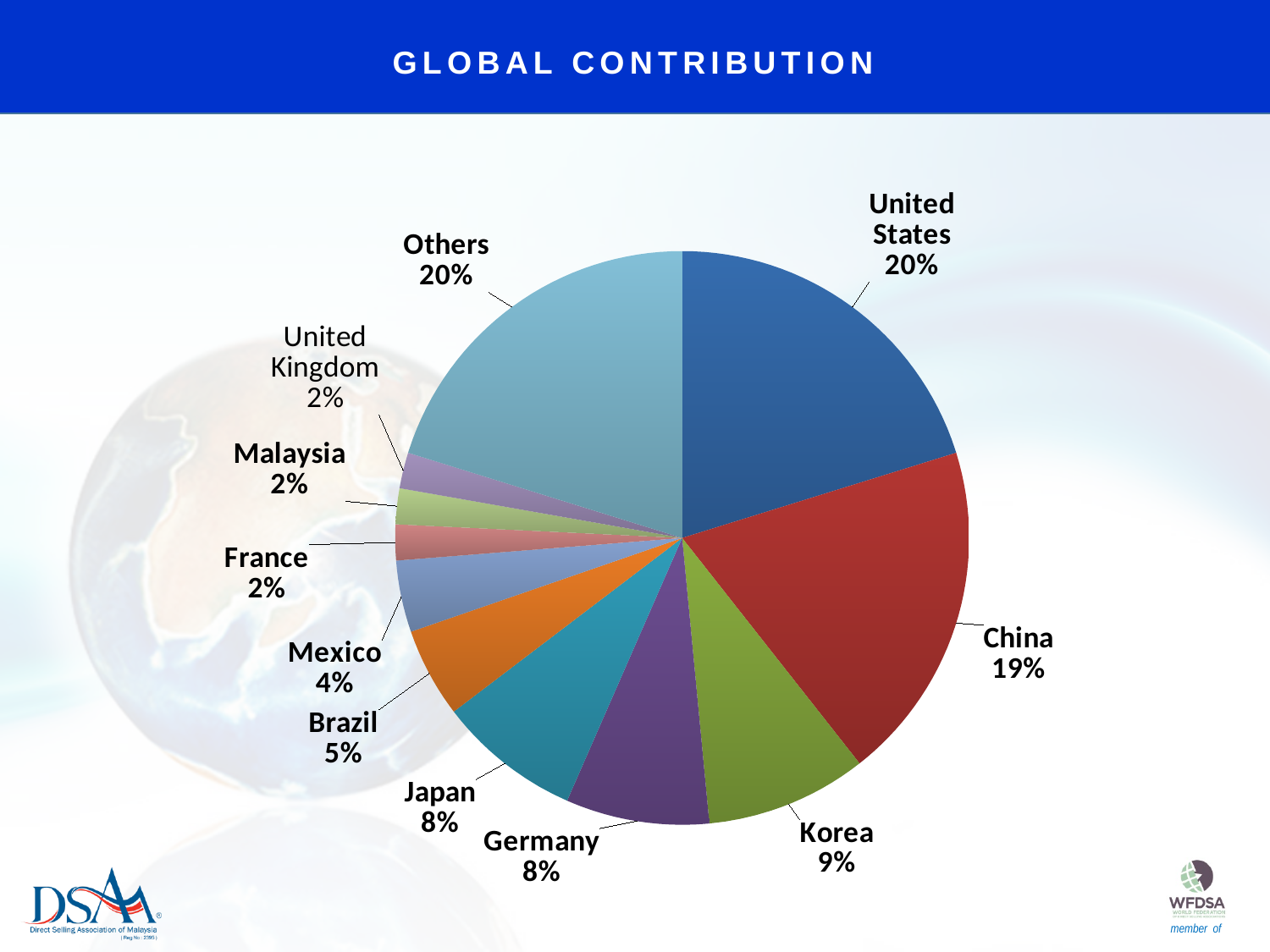
What is the difference between the shares for the United States and Brazil? 15% Which is larger, the share for the United States or the share for China? United States What type of chart is shown on the slide? pie chart What percentage is shown for the United Kingdom? 2% What percentage is shown for Brazil? 5% How many slices does the pie chart have? 11 What is the value shown for Korea? 9% What is the combined share of Germany and Japan? 16% What share of the pie does China account for? 19% What is the title of the chart? GLOBAL CONTRIBUTION What share is shown for Mexico? 4% Which is larger, the share for Korea or the share for Japan? Korea